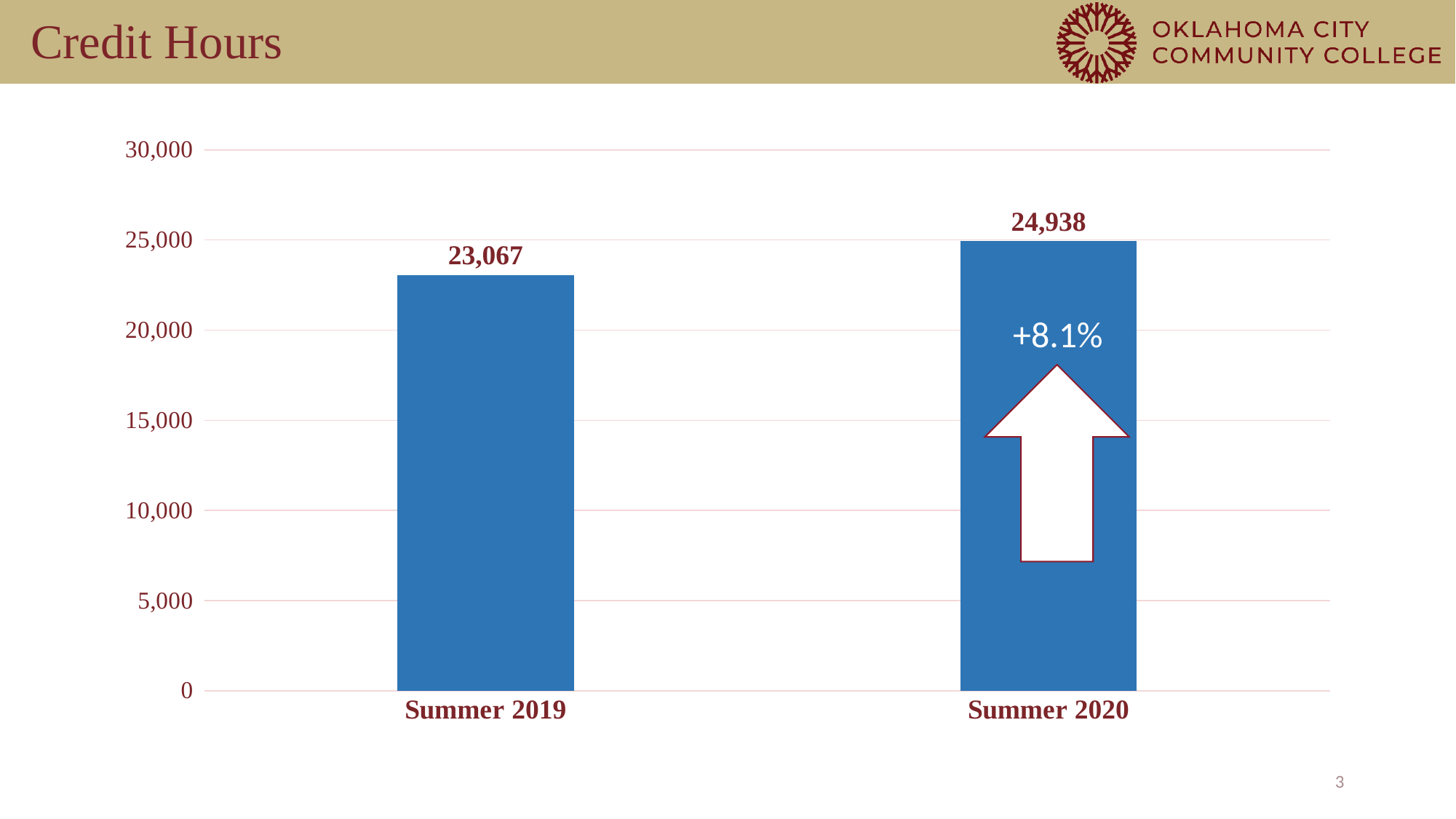
How many categories are shown on the chart? 2 What is the value for Summer 2019? 23,067 Which category has the lowest value? Summer 2019 Is the value for Summer 2020 greater or less than 20,000? greater What kind of chart is shown on the slide? bar chart Which is larger, the value for Summer 2019 or Summer 2020? Summer 2020 What is the value for Summer 2020? 24,938 Do the values rise or fall from Summer 2019 to Summer 2020? rise What is the difference between the Summer 2020 and Summer 2019 values? 1,871 Is the value for Summer 2019 greater or less than 25,000? less What percentage change is printed on the Summer 2020 bar? +8.1% Which category has the highest value? Summer 2020